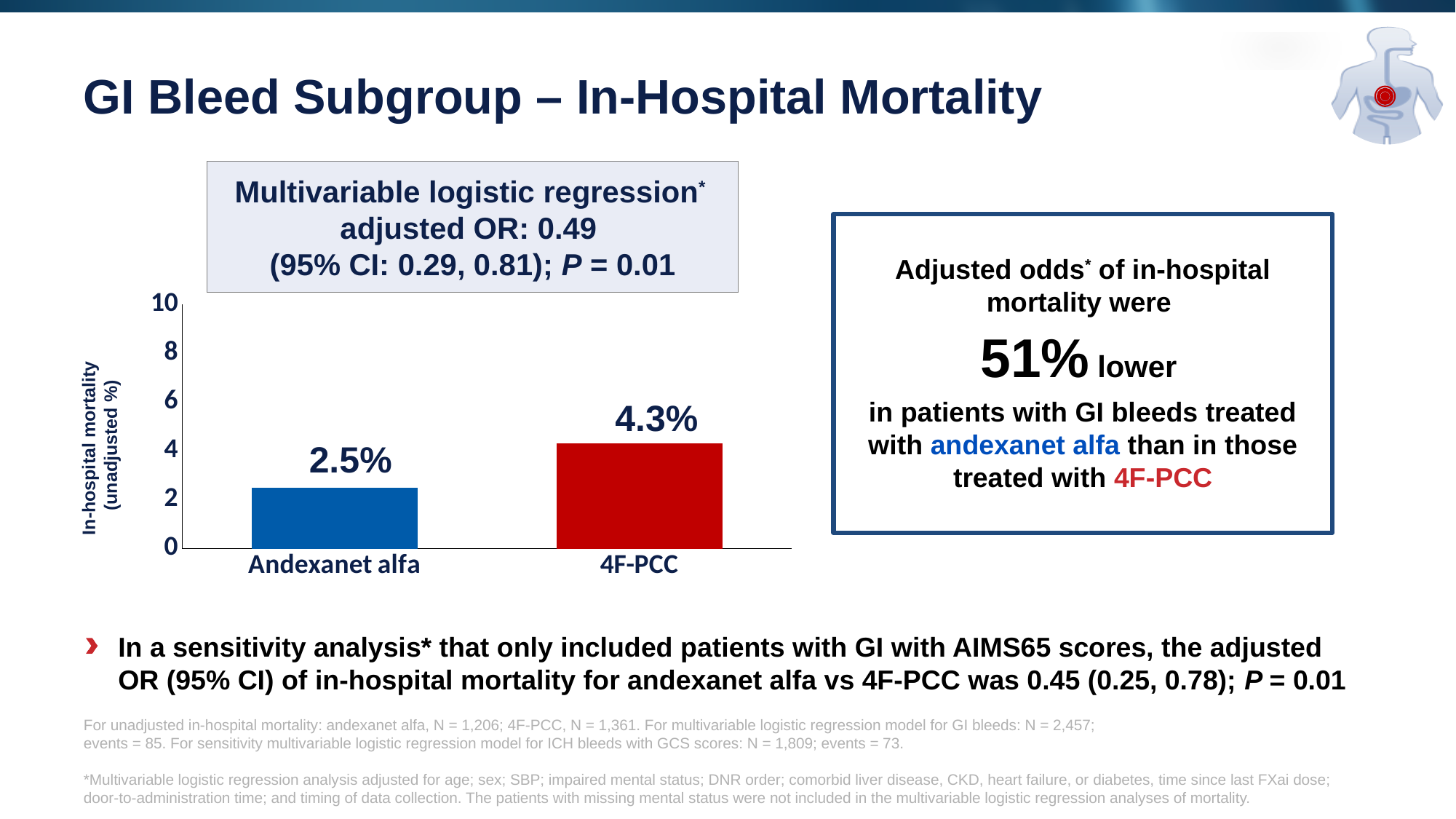
Which category has the highest in-hospital mortality? 4F-PCC Is the value for 4F-PCC greater or less than 4? greater What kind of chart is shown on the slide? Bar chart What is the in-hospital mortality value for 4F-PCC? 4.3% What is the maximum value shown on the y axis of the chart? 10 What is the y-axis label of the chart? In-hospital mortality (unadjusted %) Is the value for Andexanet alfa greater or less than 4? less Which has a larger in-hospital mortality value, Andexanet alfa or 4F-PCC? 4F-PCC What is the difference in in-hospital mortality between 4F-PCC and Andexanet alfa? 1.8% How many categories are shown on the x axis of the chart? 2 What is the in-hospital mortality value for Andexanet alfa? 2.5% Which category has the lowest in-hospital mortality? Andexanet alfa